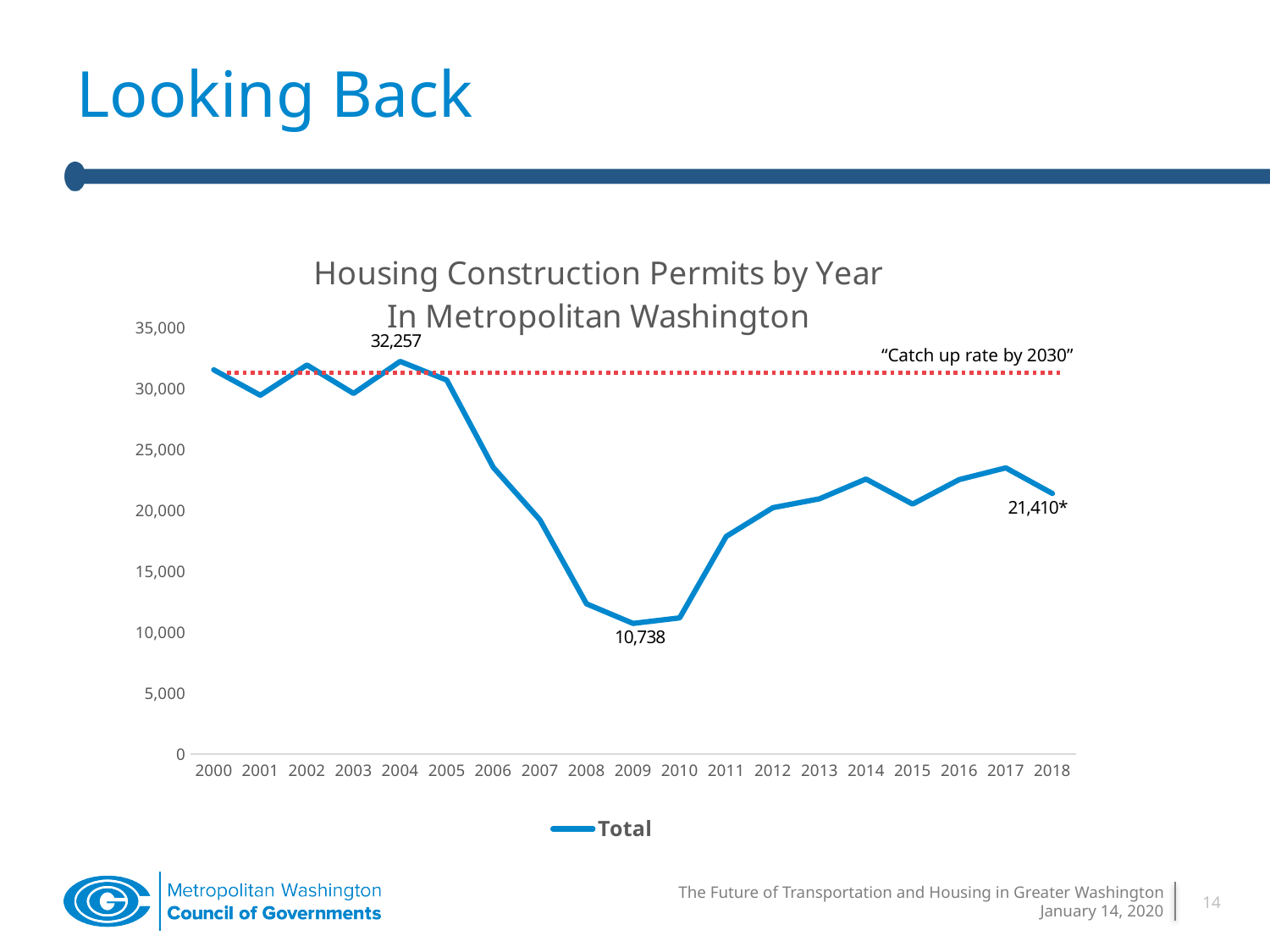
How many years are plotted on the x axis? 19 In which year was the number of housing construction permits highest? 2004 In which year was the number of housing construction permits lowest? 2009 How many series does the legend list? 1 Did the number of permits rise or fall from 2005 to 2009? fall What value is labeled for 2018? 21,410* Is the value for 2006 greater or less than 25,000? less What is the value of housing construction permits in 2009? 10,738 What is the difference between the 2004 value and the 2009 value? 21,519 What label is attached to the red dotted line? "Catch up rate by 2030" What is the value of housing construction permits in 2004? 32,257 What kind of chart is shown on the slide? line chart